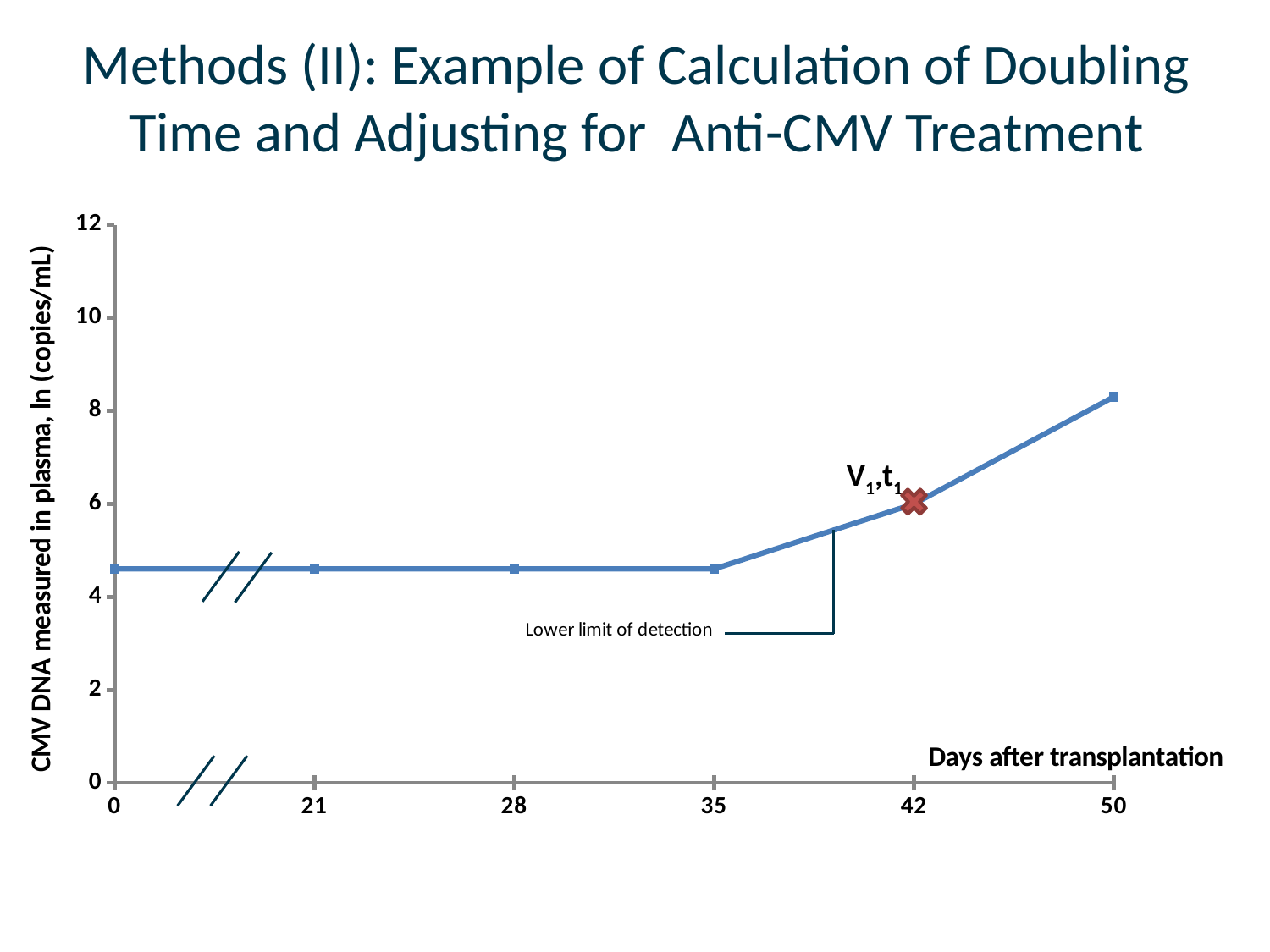
What is the label of the x axis? Days after transplantation What kind of chart is shown on the slide? line chart Which is larger, the value at day 35 or the value at day 42? day 42 How does the CMV DNA value change between day 35 and day 50? it rises How many data points are plotted on the line? 6 At which day after transplantation is the CMV DNA value highest? 50 Is the value at day 50 greater or less than 6? greater Which is larger, the value at day 42 or the value at day 50? day 50 What does the annotation pointing to the flat part of the line say? Lower limit of detection Is the value at day 0 greater or less than 4? greater Is the value at day 42 greater or less than 8? less